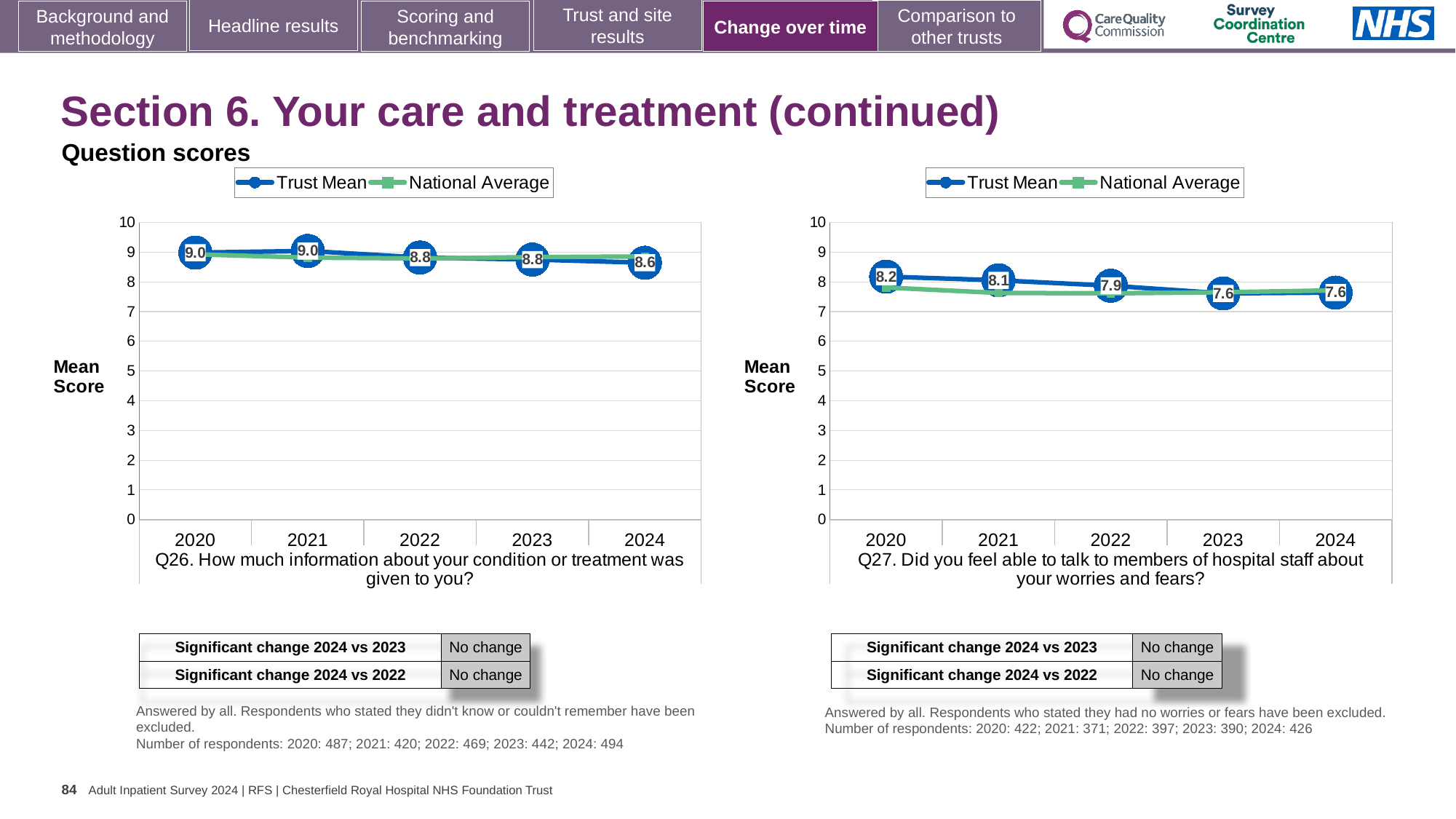
In the Q27 chart on the right, is the National Average for 2024 greater or less than 7? greater In the Q27 chart on the right, what is the Trust Mean score for 2024? 7.6 In the Q27 chart on the right, which year has the highest Trust Mean score? 2020 In the Q26 chart on the left, does the Trust Mean rise or fall from 2020 to 2024? fall In the Q27 chart on the right, what is the difference between the Trust Mean in 2020 and in 2023? 0.6 How many years are plotted on the x axis of the Q27 chart on the right? 5 In the Q26 chart on the left, is the Trust Mean for 2020 or for 2024 higher? 2020 How many series does the legend of the Q26 chart on the left list? 2 In the Q26 chart on the left, what is the Trust Mean score for 2020? 9.0 In the Q26 chart on the left, what is the Trust Mean score for 2024? 8.6 In the Q27 chart on the right, what is the Trust Mean score for 2022? 7.9 In the Q26 chart on the left, by how much did the Trust Mean fall from 2020 to 2024? 0.4